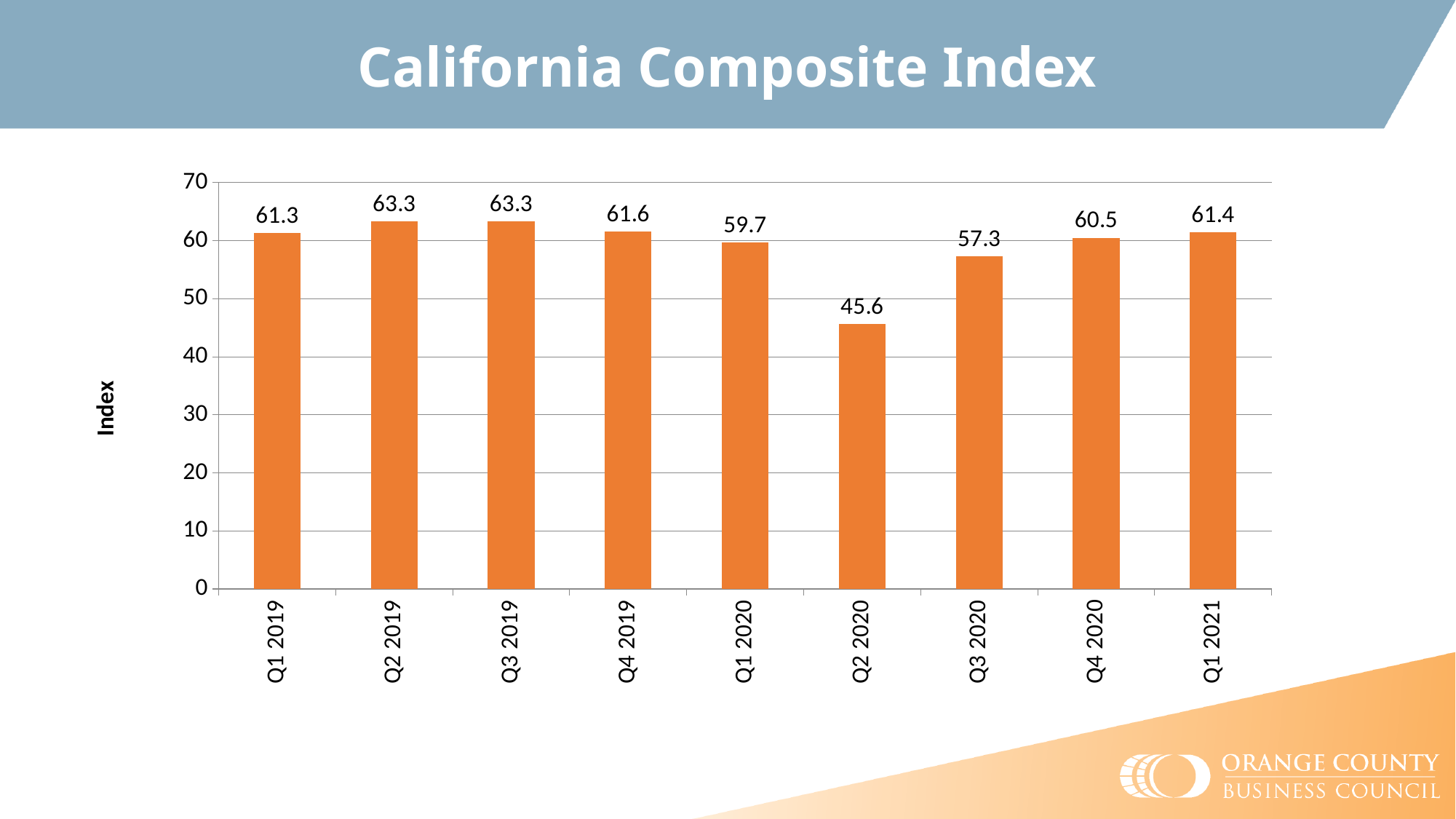
What is the label on the vertical axis of the chart? Index What is the California Composite Index value for Q2 2020? 45.6 What is the difference between the Q1 2021 value and the Q4 2020 value? 0.9 Which is larger, the value for Q4 2019 or the value for Q1 2020? Q4 2019 What kind of chart is shown on the slide? Bar chart Is the value for Q2 2020 greater or less than 50? less What is the California Composite Index value for Q3 2020? 57.3 What is the difference between the Q1 2020 value and the Q2 2020 value? 14.1 What is the California Composite Index value for Q1 2021? 61.4 Which quarter has the lowest California Composite Index value? Q2 2020 How many quarters are shown on the chart? 9 What is the highest value shown on the chart? 63.3